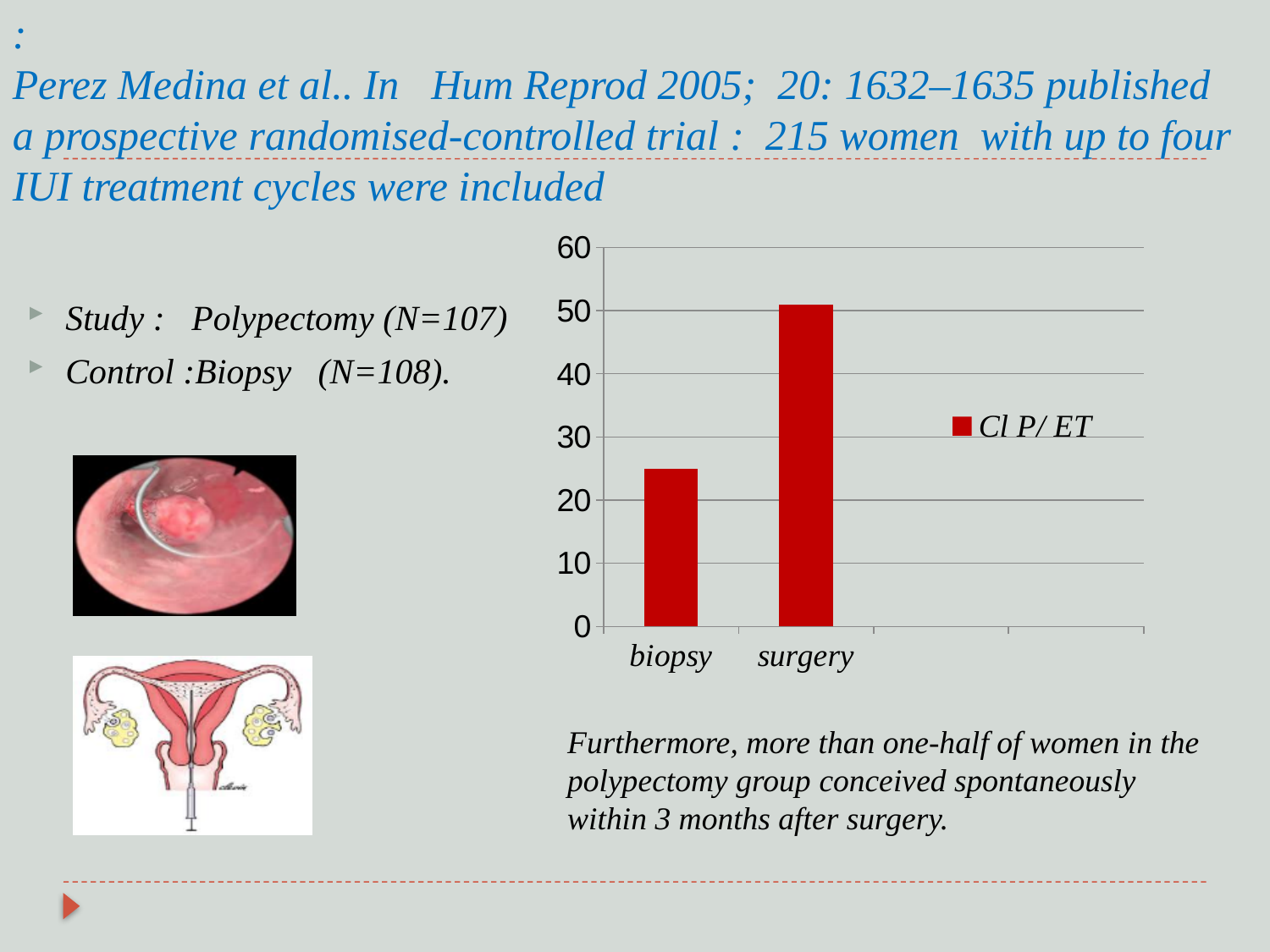
How many series does the chart legend list? 1 Which is larger in the chart, the value for biopsy or the value for surgery? surgery Is the value for biopsy greater or less than 30? less Is the value for surgery greater or less than 60? less Is the value for biopsy greater or less than 20? greater Which category has the lowest bar in the chart? biopsy Which category has the highest bar in the chart? surgery What colour are the bars in the chart? red What is the name of the series shown in the chart legend? Cl P/ ET How many categories are plotted on the x axis of the chart? 2 What kind of chart is shown on the slide? bar chart